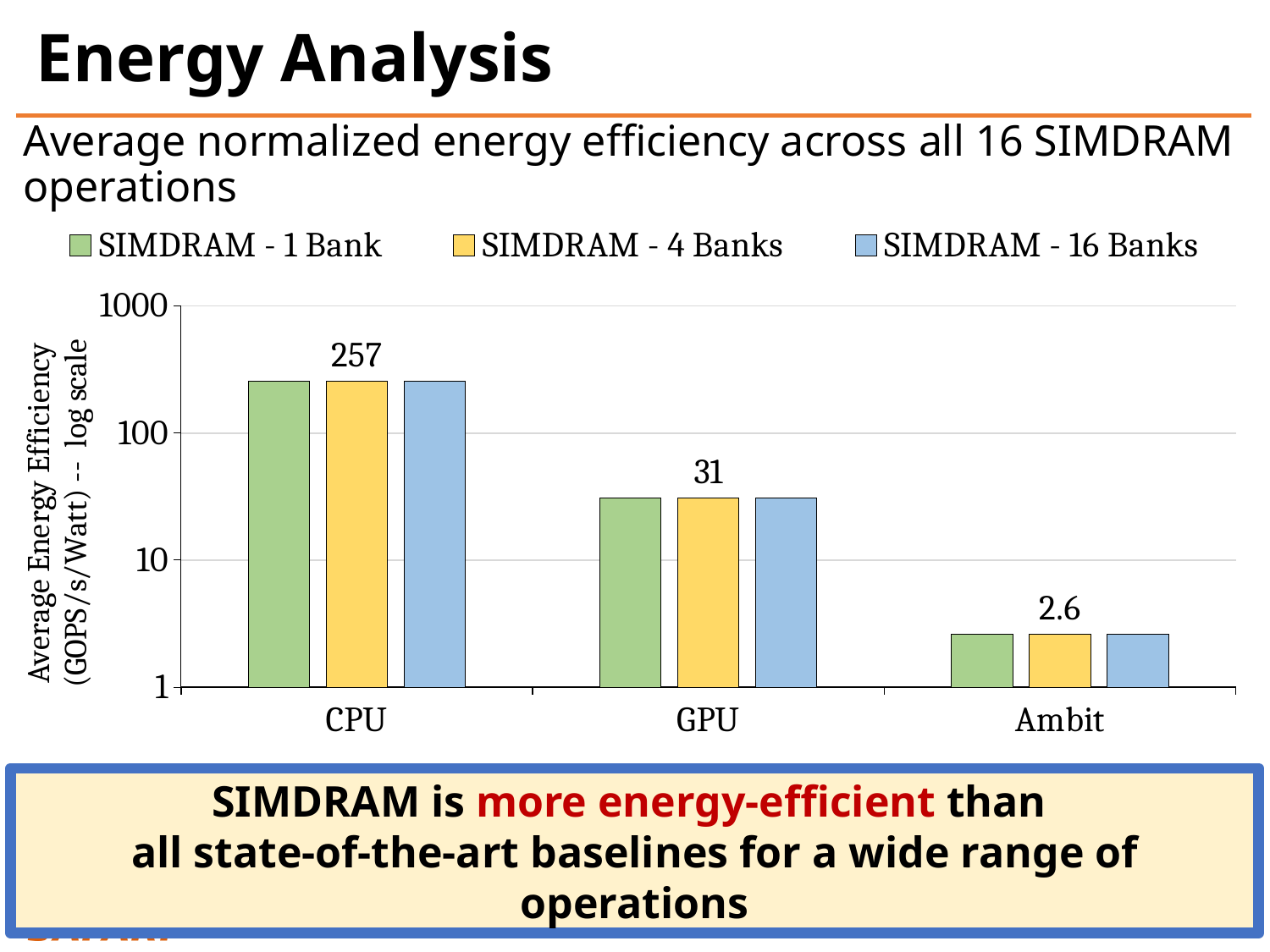
Is the SIMDRAM - 4 Banks value larger for CPU or for GPU? CPU What kind of chart is shown on the slide? bar chart What is the value labelled for SIMDRAM - 4 Banks at CPU? 257 How many series does the legend list? 3 Which baseline category has the highest average energy efficiency values? CPU What is the value labelled for SIMDRAM - 4 Banks at Ambit? 2.6 What is the difference between the labelled SIMDRAM - 4 Banks values for CPU and GPU? 226 Is the value for SIMDRAM - 16 Banks at GPU greater or less than 100? less How many baseline categories are shown on the x axis? 3 Which baseline category has the lowest average energy efficiency values? Ambit Is the value for SIMDRAM - 1 Bank at Ambit greater or less than 10? less What is the value labelled for SIMDRAM - 4 Banks at GPU? 31